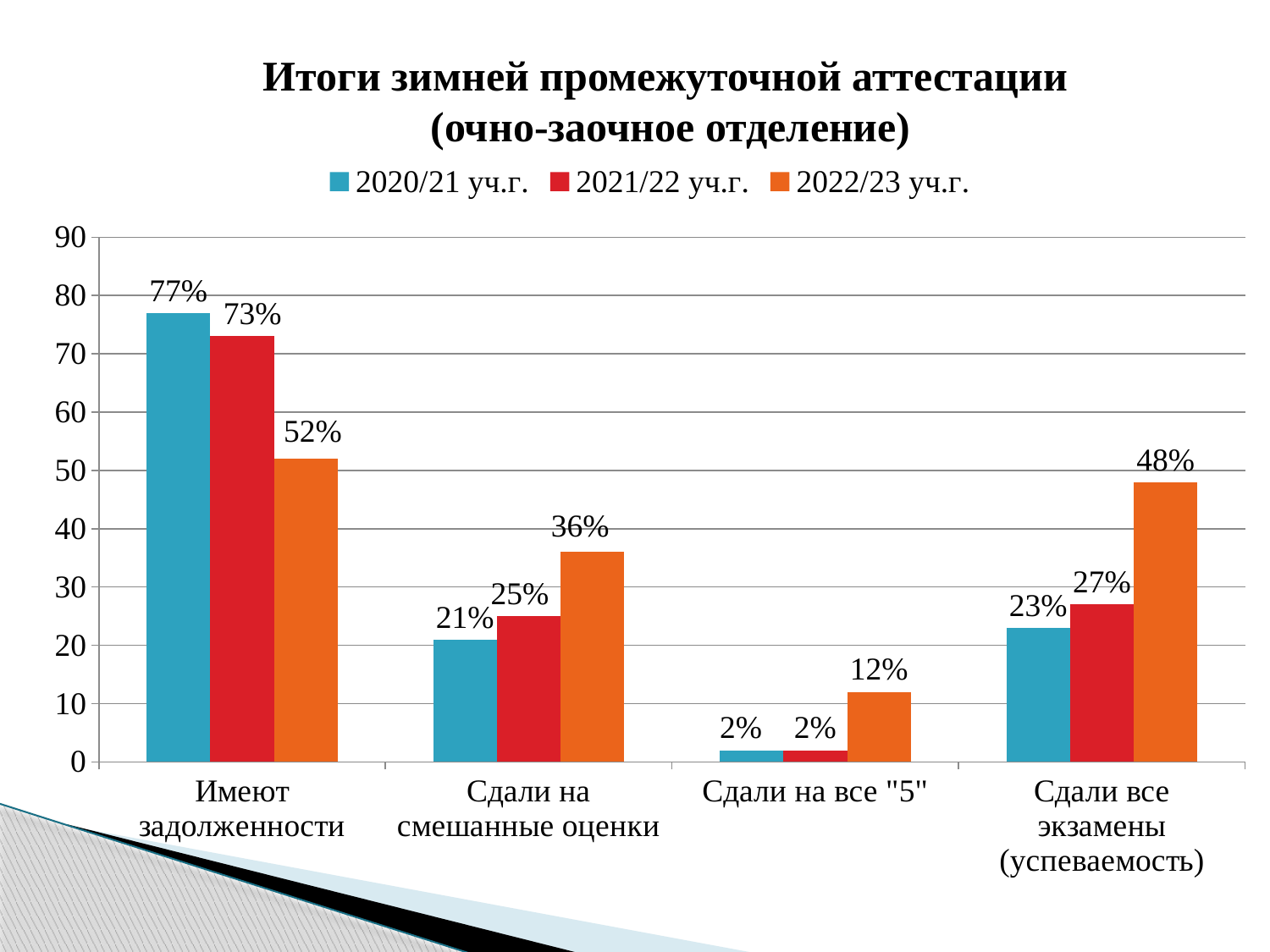
What is the value for 2021/22 уч.г. in the category "Сдали на смешанные оценки"? 25% Across the three academic years, do the values in the category "Сдали все экзамены (успеваемость)" rise or fall? Rise What is the difference between the 2020/21 уч.г. and 2022/23 уч.г. values in the category "Имеют задолженности"? 25% How many series does the legend list? 3 In the category "Сдали все экзамены (успеваемость)", which is larger: the value for 2021/22 уч.г. or for 2022/23 уч.г.? 2022/23 уч.г. Which category has the lowest value for 2022/23 уч.г.? Сдали на все "5" What kind of chart is shown on the slide? Bar chart Which category has the highest value for 2020/21 уч.г.? Имеют задолженности What is the value for 2022/23 уч.г. in the category "Имеют задолженности"? 52% What is the title of the chart? Итоги зимней промежуточной аттестации (очно-заочное отделение) What is the value for 2020/21 уч.г. in the category "Сдали все экзамены (успеваемость)"? 23% How many categories are shown on the x axis? 4